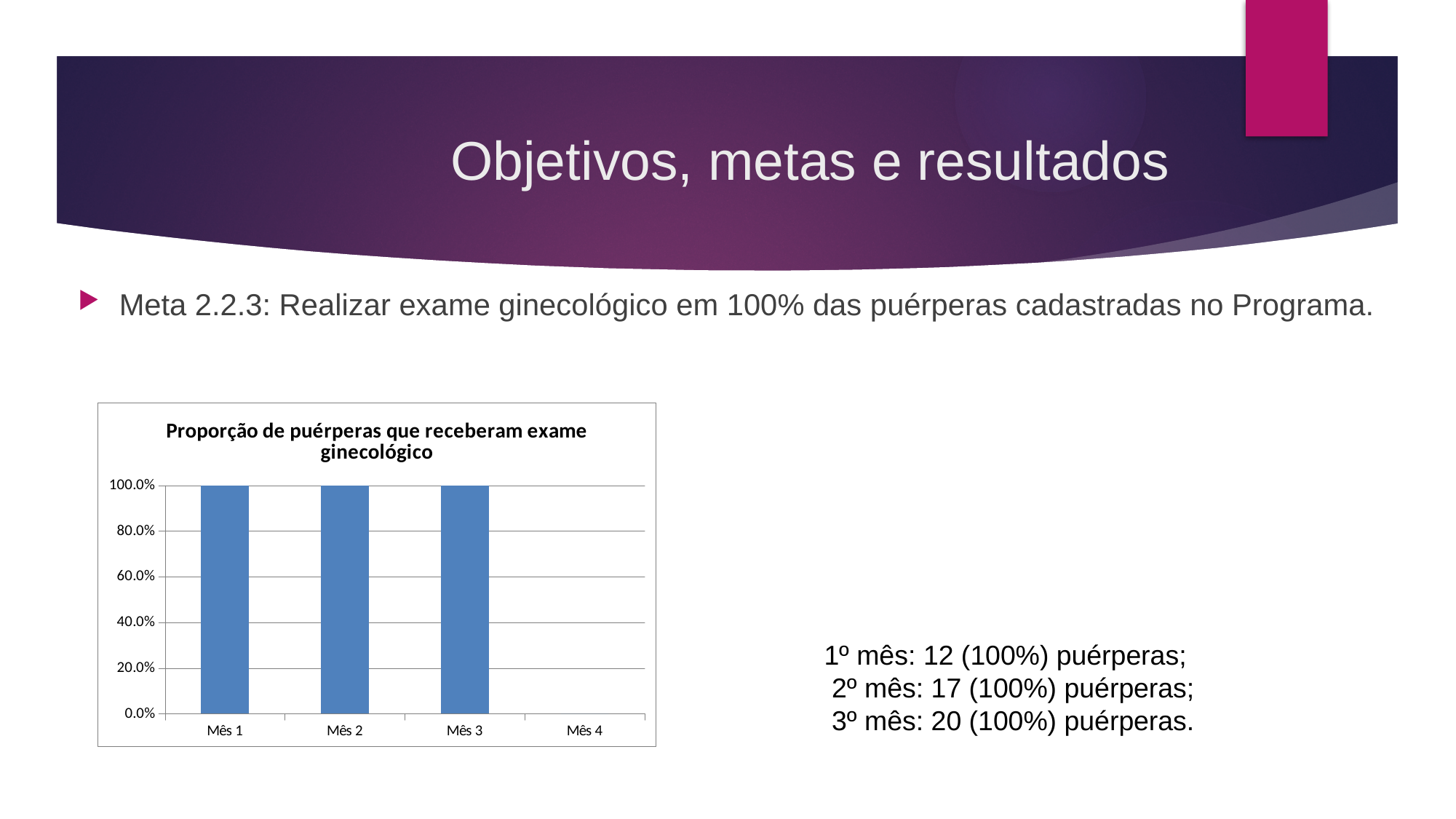
What kind of chart is shown on the slide? bar chart What is the value for Mês 2? 100.0% Which category has the lowest value in the chart? Mês 4 Which is larger, the value for Mês 3 or the value for Mês 4? Mês 3 Is the value for Mês 4 greater or less than 20.0%? less What is the value for Mês 1? 100.0% Is the value for Mês 2 greater or less than 80.0%? greater What colour are the bars in the chart? blue What is the title of the chart? Proporção de puérperas que receberam exame ginecológico What is the value for Mês 3? 100.0% What is the difference between the values for Mês 1 and Mês 3? 0.0% How many categories are shown on the x axis of the chart? 4